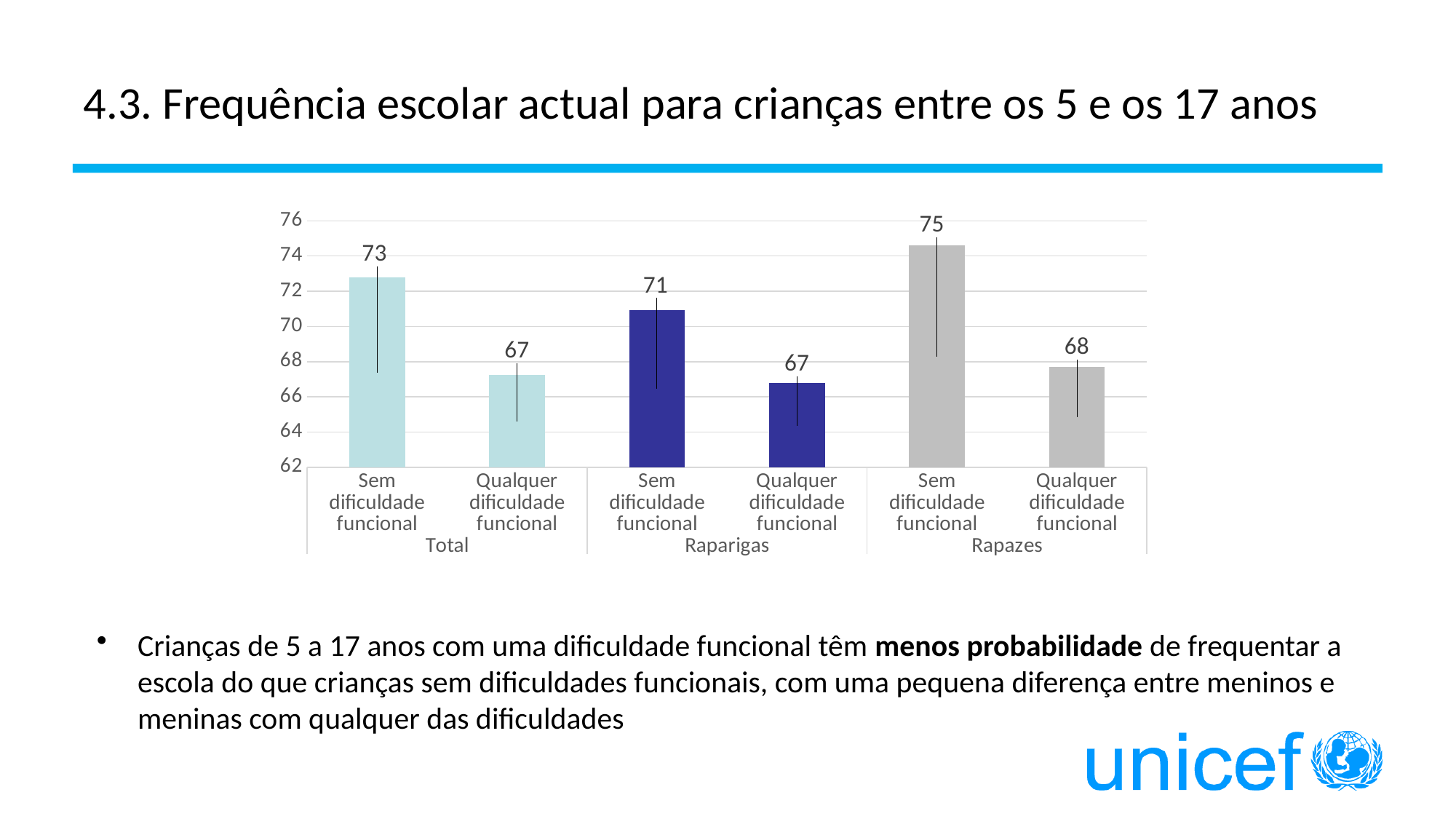
How many bars are plotted on the chart? 6 Which bar has the highest value on the chart? Sem dificuldade funcional (Rapazes) What kind of chart is shown on the slide? Bar chart Which is larger: 'Sem dificuldade funcional' for Raparigas or 'Sem dificuldade funcional' for Rapazes? Rapazes What is the value for 'Sem dificuldade funcional' in the Rapazes group? 75 What are the three group labels shown along the x axis? Total, Raparigas, Rapazes What is the value for 'Sem dificuldade funcional' in the Total group? 73 What is the value for 'Qualquer dificuldade funcional' in the Rapazes group? 68 What is the difference between 'Sem dificuldade funcional' and 'Qualquer dificuldade funcional' in the Total group? 6 What is the value for 'Qualquer dificuldade funcional' in the Raparigas group? 67 Is the value for 'Sem dificuldade funcional' in the Raparigas group greater or less than 70? greater What is the difference between 'Sem dificuldade funcional' and 'Qualquer dificuldade funcional' in the Rapazes group? 7